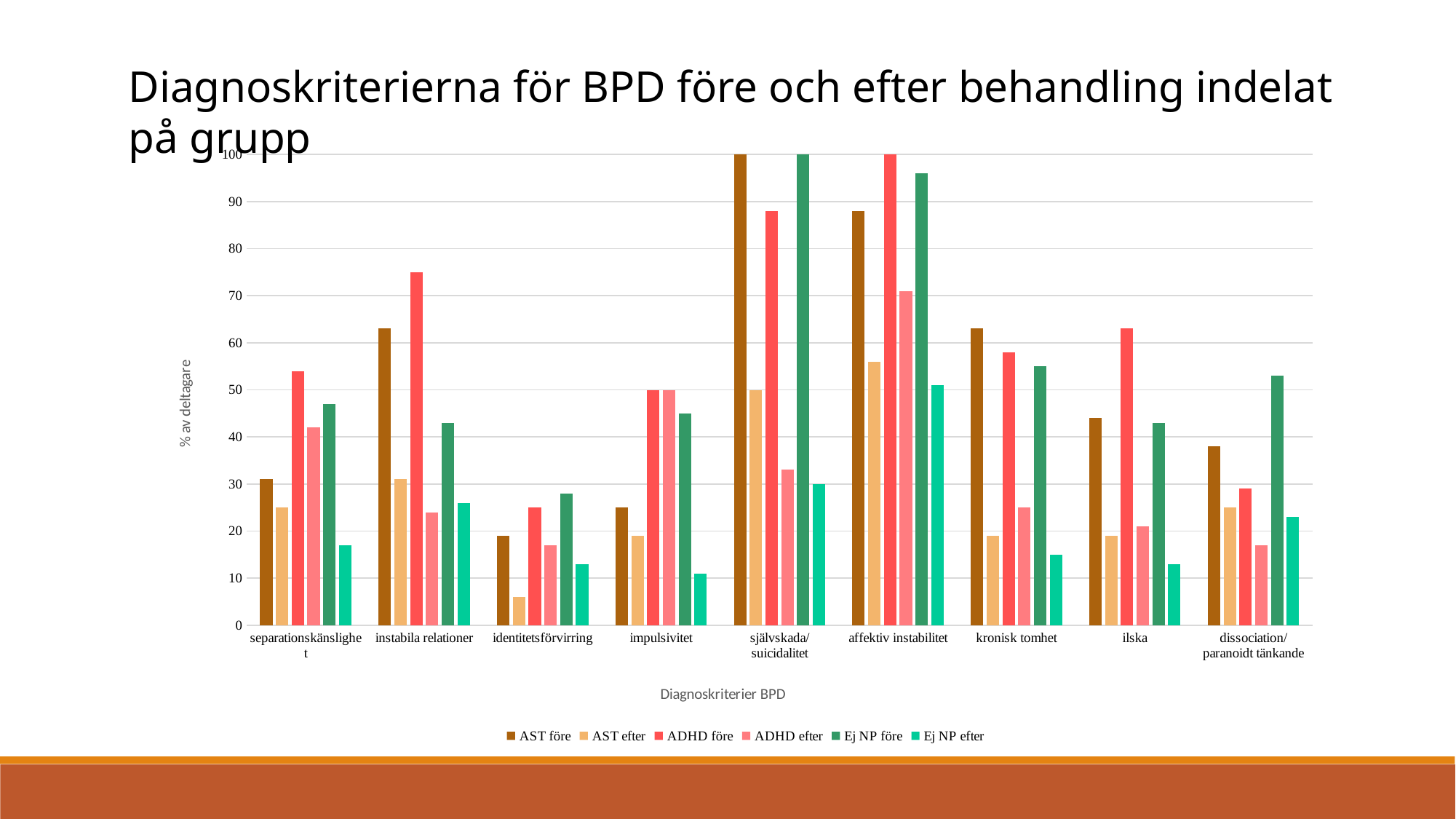
Is the value for ADHD före in the instabila relationer category greater or less than 70? greater What is the value for ADHD före in the affektiv instabilitet category? 100 Which category has the lowest value for AST efter? identitetsförvirring Is the value for Ej NP efter in the kronisk tomhet category greater or less than 20? less What is the value for AST före in the självskada/suicidalitet category? 100 What is the label on the y axis? % av deltagare How many series does the legend list? 6 Which category has the highest value for AST före? självskada/suicidalitet What is the title of the x axis? Diagnoskriterier BPD How many diagnostic criteria categories are shown on the x axis? 9 In the instabila relationer category, which is larger: AST före or ADHD före? ADHD före What kind of chart is shown on the slide? bar chart